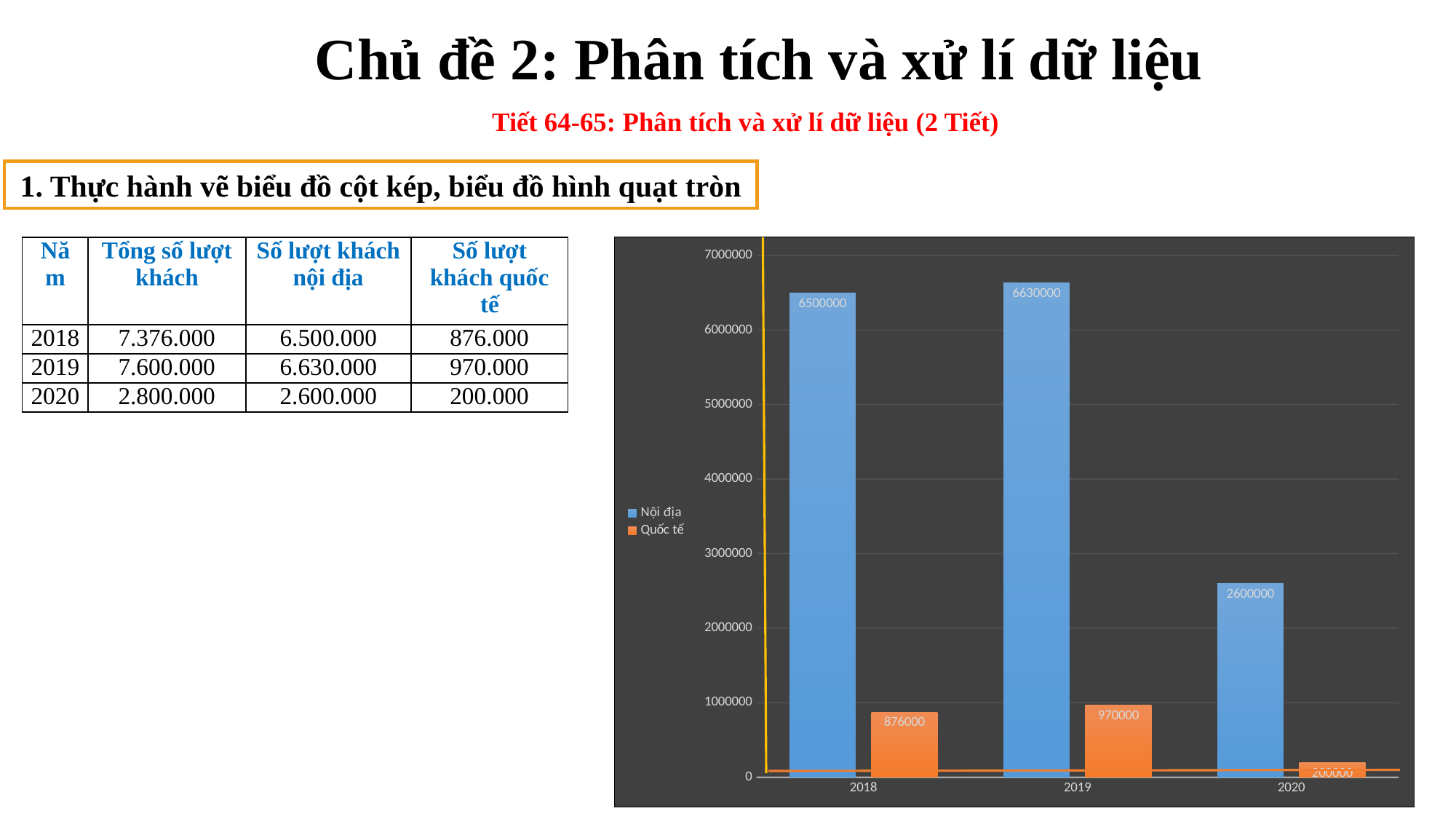
Which year has the highest Nội địa value? 2019 What is the value of Quốc tế for 2018? 876000 What kind of chart is shown on the slide? bar chart Is the Nội địa value for 2020 greater or less than 3000000? less What is the value of Nội địa for 2020? 2600000 Which year has the lowest Quốc tế value? 2020 Which colour represents the Quốc tế series in the chart? orange How many years are shown on the x axis of the chart? 3 Which is larger, Quốc tế in 2019 or Quốc tế in 2018? Quốc tế in 2019 How many series does the chart legend list? 2 What is the value of Nội địa for 2019? 6630000 What is the difference between the Nội địa values for 2019 and 2018? 130000